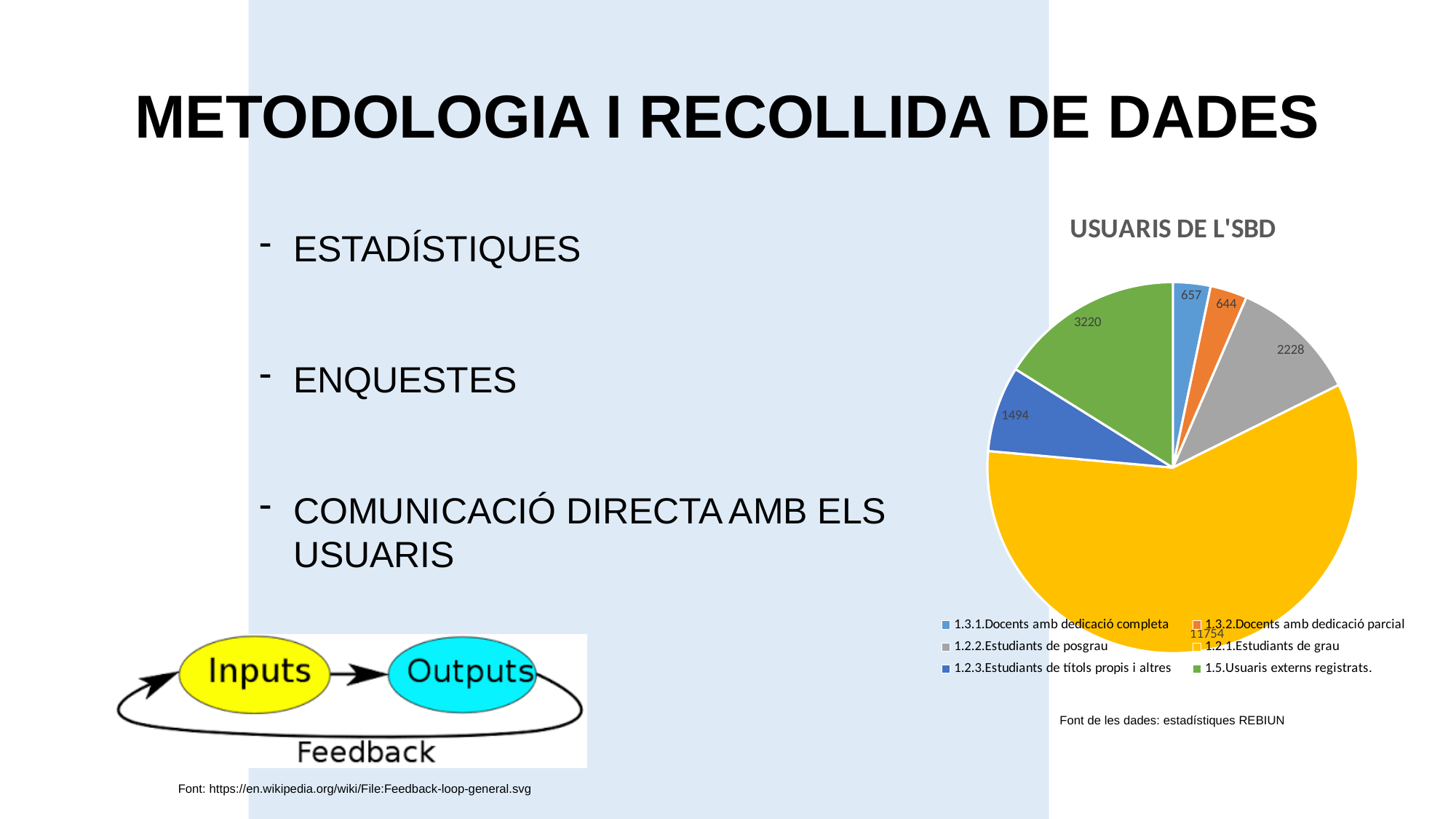
What is the value for 1.2.1.Estudiants de grau in the pie chart? 11754 What is the value for 1.3.1.Docents amb dedicació completa in the pie chart? 657 Which is larger: the value for 1.2.2.Estudiants de posgrau or for 1.2.3.Estudiants de títols propis i altres? 1.2.2.Estudiants de posgrau Which category has the largest slice in the pie chart? 1.2.1.Estudiants de grau How many slices does the pie chart have? 6 Which category has the smallest slice in the pie chart? 1.3.2.Docents amb dedicació parcial What is the value for 1.2.2.Estudiants de posgrau in the pie chart? 2228 What is the title of the pie chart? USUARIS DE L'SBD What is the value for 1.5.Usuaris externs registrats. in the pie chart? 3220 What type of chart is shown on the slide? pie chart What is the difference between the values for 1.5.Usuaris externs registrats. and 1.2.2.Estudiants de posgrau? 992 What colour is the slice for 1.2.1.Estudiants de grau? yellow